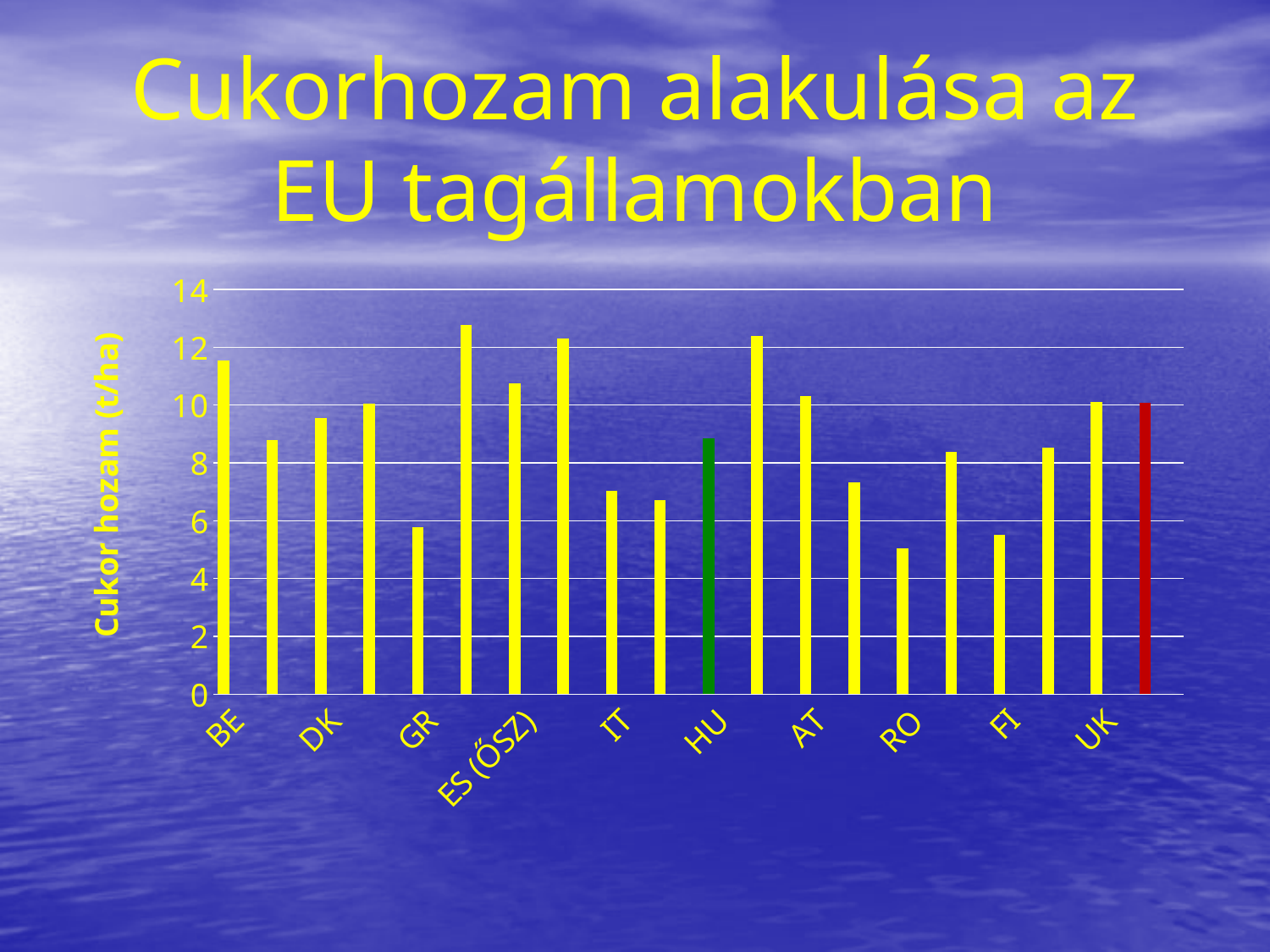
Is the value for IT greater or less than 8? less What is the label of the vertical axis? Cukor hozam (t/ha) Is the value for AT greater or less than 10? greater Is the value for BE greater or less than 10? greater What is the title of the chart on the slide? Cukorhozam alakulása az EU tagállamokban Which has a higher value, GR or IT? IT How many bars are plotted in the chart? 20 Which has a higher value, BE or DK? BE What kind of chart is shown on the slide? bar chart